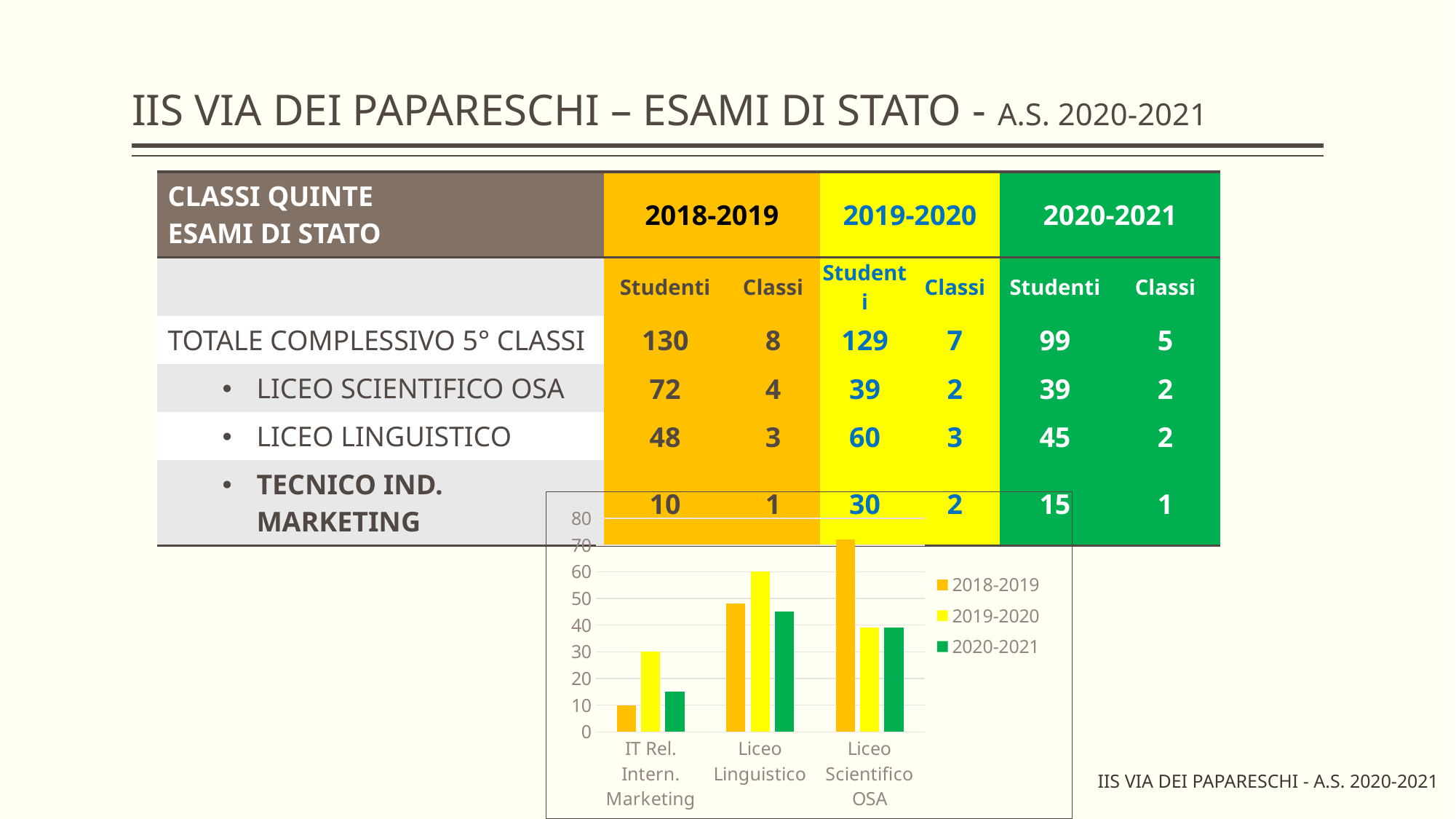
How many categories are shown on the x axis of the chart? 3 How many series does the chart's legend list? 3 In the chart, is the 2018-2019 value for Liceo Scientifico OSA greater or less than 60? greater In the chart, which category has the lowest 2018-2019 bar? IT Rel. Intern. Marketing In the chart, for Liceo Linguistico, which series has the larger value: 2019-2020 or 2020-2021? 2019-2020 What type of chart is shown on the slide? bar chart In the chart, which category has the highest 2018-2019 bar? Liceo Scientifico OSA In the chart, do the 2018-2019 values rise or fall from left to right along the x axis? rise In the chart, is the 2020-2021 value for Liceo Linguistico greater or less than 50? less In the chart, what is the value for IT Rel. Intern. Marketing in the 2019-2020 series? 30 In the chart, what is the value for Liceo Linguistico in the 2019-2020 series? 60 In the chart, what is the value for IT Rel. Intern. Marketing in the 2018-2019 series? 10